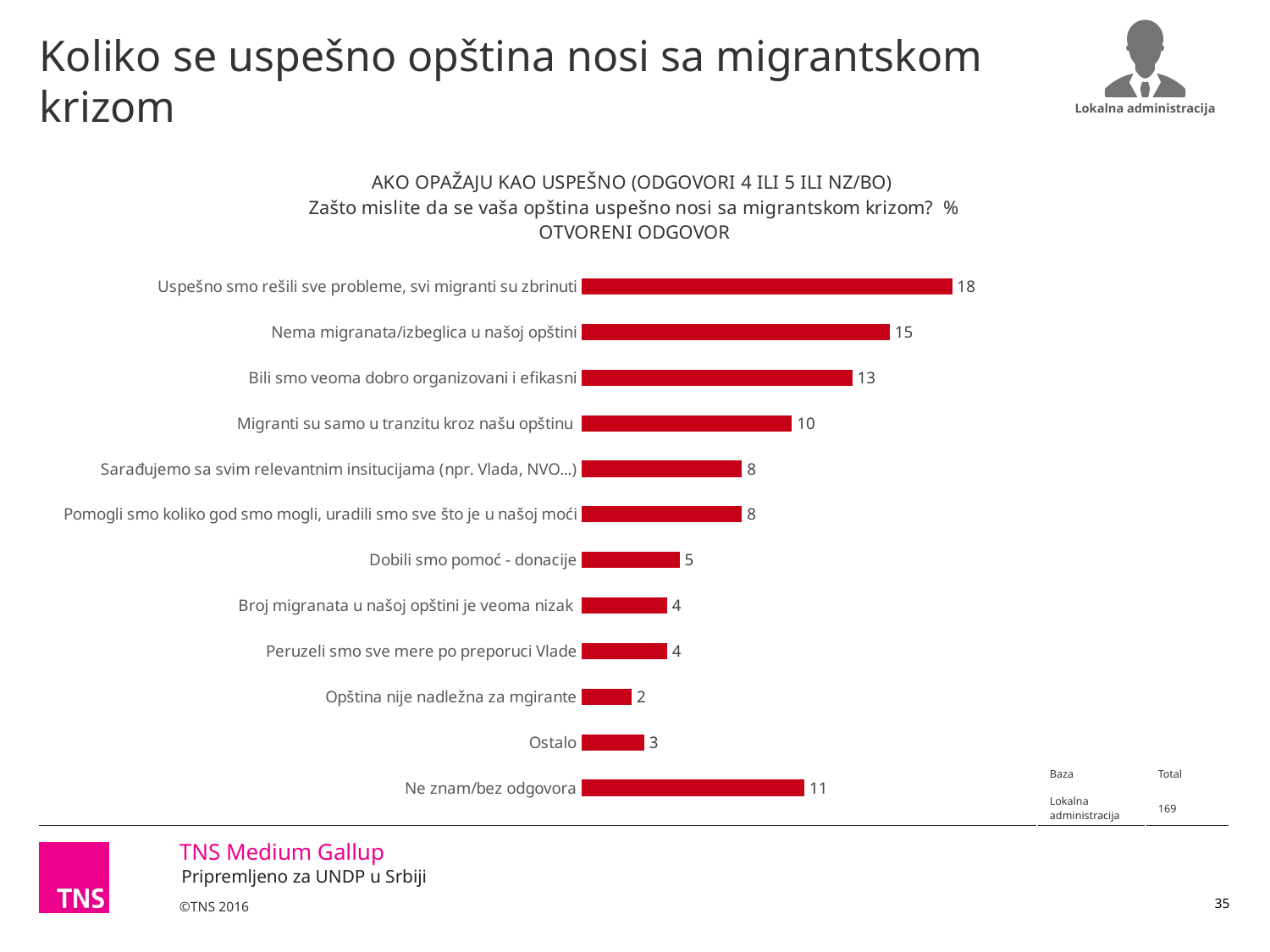
Which is larger: the value for "Migranti su samo u tranzitu kroz našu opštinu" or the value for "Ne znam/bez odgovora"? Ne znam/bez odgovora What is the difference between the values for "Ostalo" and "Opština nije nadležna za mgirante"? 1 What value is shown for "Dobili smo pomoć - donacije"? 5 What colour are the bars in the chart? Red What value is shown for "Uspešno smo rešili sve probleme, svi migranti su zbrinuti"? 18 What is the difference between the values for "Uspešno smo rešili sve probleme, svi migranti su zbrinuti" and "Bili smo veoma dobro organizovani i efikasni"? 5 What value is shown for "Ne znam/bez odgovora"? 11 What kind of chart is shown on the slide? Bar chart How many categories are shown in the chart? 12 Which category has the highest value? Uspešno smo rešili sve probleme, svi migranti su zbrinuti Which category has the lowest value? Opština nije nadležna za mgirante What value is shown for "Nema migranata/izbeglica u našoj opštini"? 15